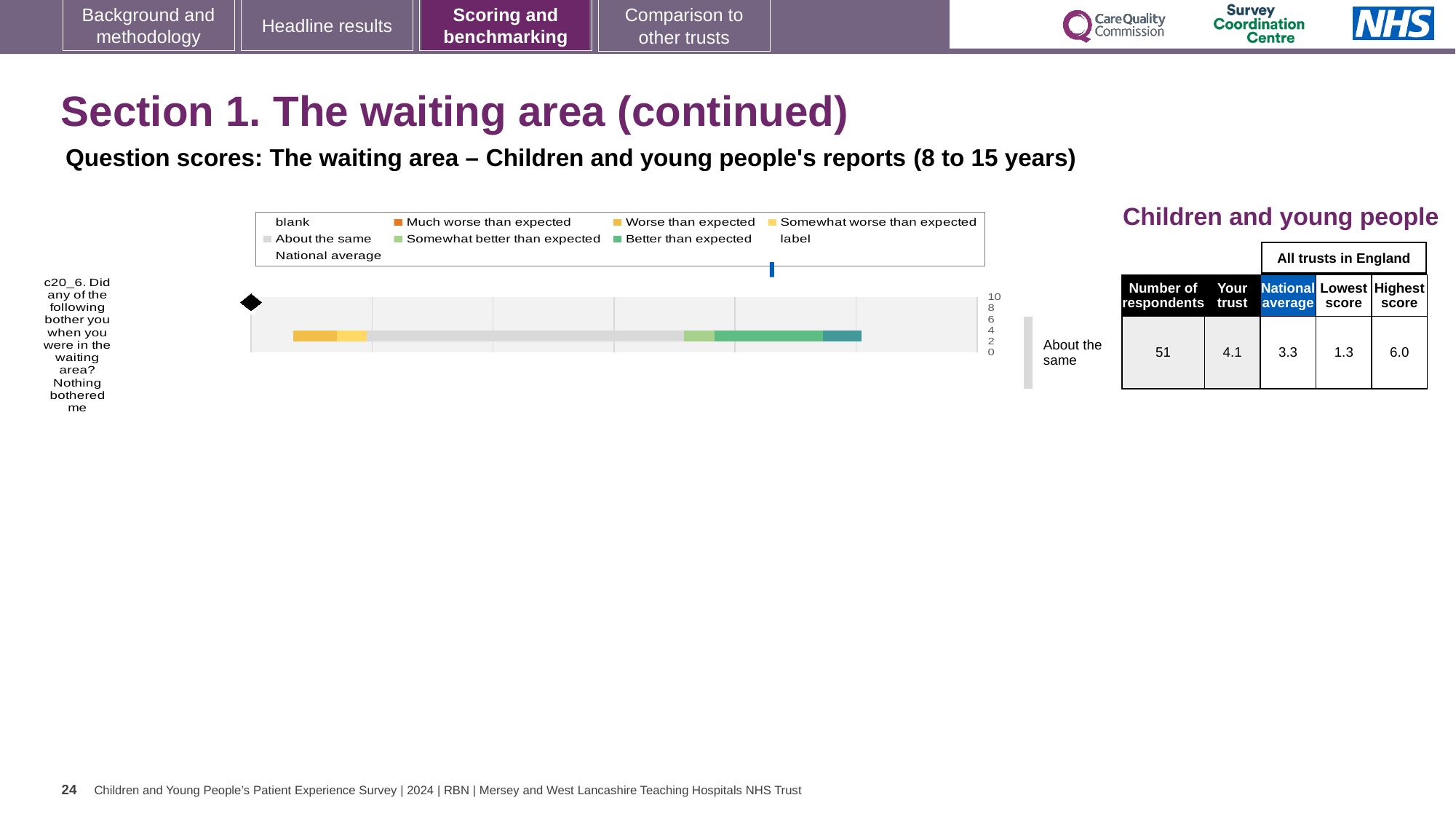
Is the trust's score for question c20_6 higher or lower than the national average? higher How many respondents answered question c20_6? 51 How many questions (categories) are plotted in the chart? 1 What is the difference between the trust's score and the national average for question c20_6? 0.8 What type of chart is used to show the question score for c20_6? bar chart What is the lowest score among all trusts in England for question c20_6? 1.3 What benchmark category label is shown to the right of the bar for question c20_6? About the same What is the 'Your trust' score for question c20_6 shown in the table next to the chart? 4.1 What is the highest score among all trusts in England for question c20_6? 6.0 What is the difference between the highest and lowest scores across all trusts in England for question c20_6? 4.7 What is the national average score for question c20_6? 3.3